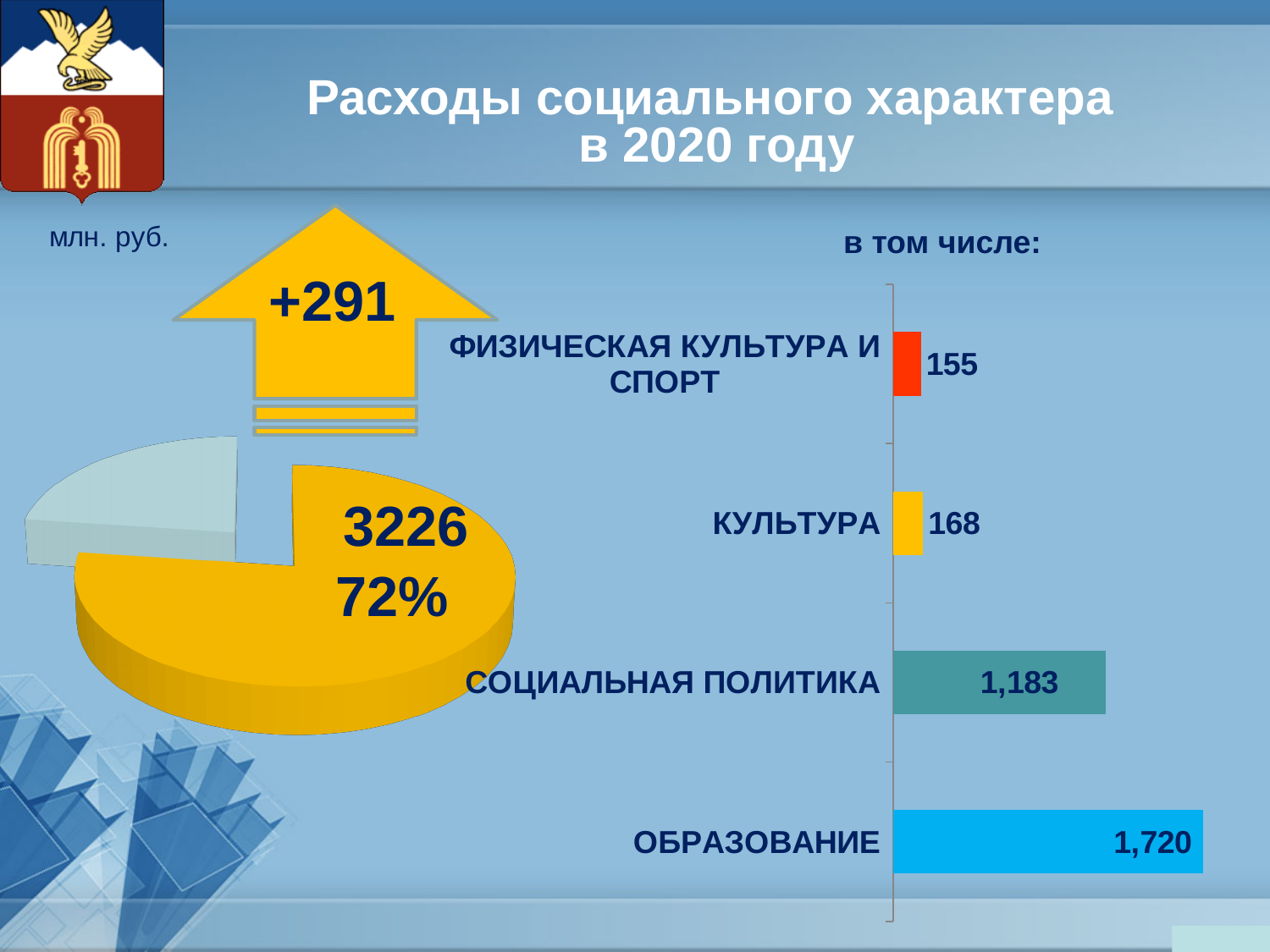
What kind of chart is shown on the right side of the slide? Bar chart On the bar chart on the right, what is the value for ФИЗИЧЕСКАЯ КУЛЬТУРА И СПОРТ? 155 On the bar chart on the right, which category has the lowest value? ФИЗИЧЕСКАЯ КУЛЬТУРА И СПОРТ On the bar chart on the right, which is larger: СОЦИАЛЬНАЯ ПОЛИТИКА or КУЛЬТУРА? СОЦИАЛЬНАЯ ПОЛИТИКА On the bar chart on the right, what is the value for ОБРАЗОВАНИЕ? 1,720 On the bar chart on the right, what is the difference between ОБРАЗОВАНИЕ and СОЦИАЛЬНАЯ ПОЛИТИКА? 537 On the bar chart on the right, what is the difference between КУЛЬТУРА and ФИЗИЧЕСКАЯ КУЛЬТУРА И СПОРТ? 13 How many categories does the bar chart on the right show? 4 On the bar chart on the right, what is the value for СОЦИАЛЬНАЯ ПОЛИТИКА? 1,183 On the bar chart on the right, what is the value for КУЛЬТУРА? 168 On the bar chart on the right, which category has the highest value? ОБРАЗОВАНИЕ On the pie chart on the left, what share is shown for the labelled yellow slice? 72%